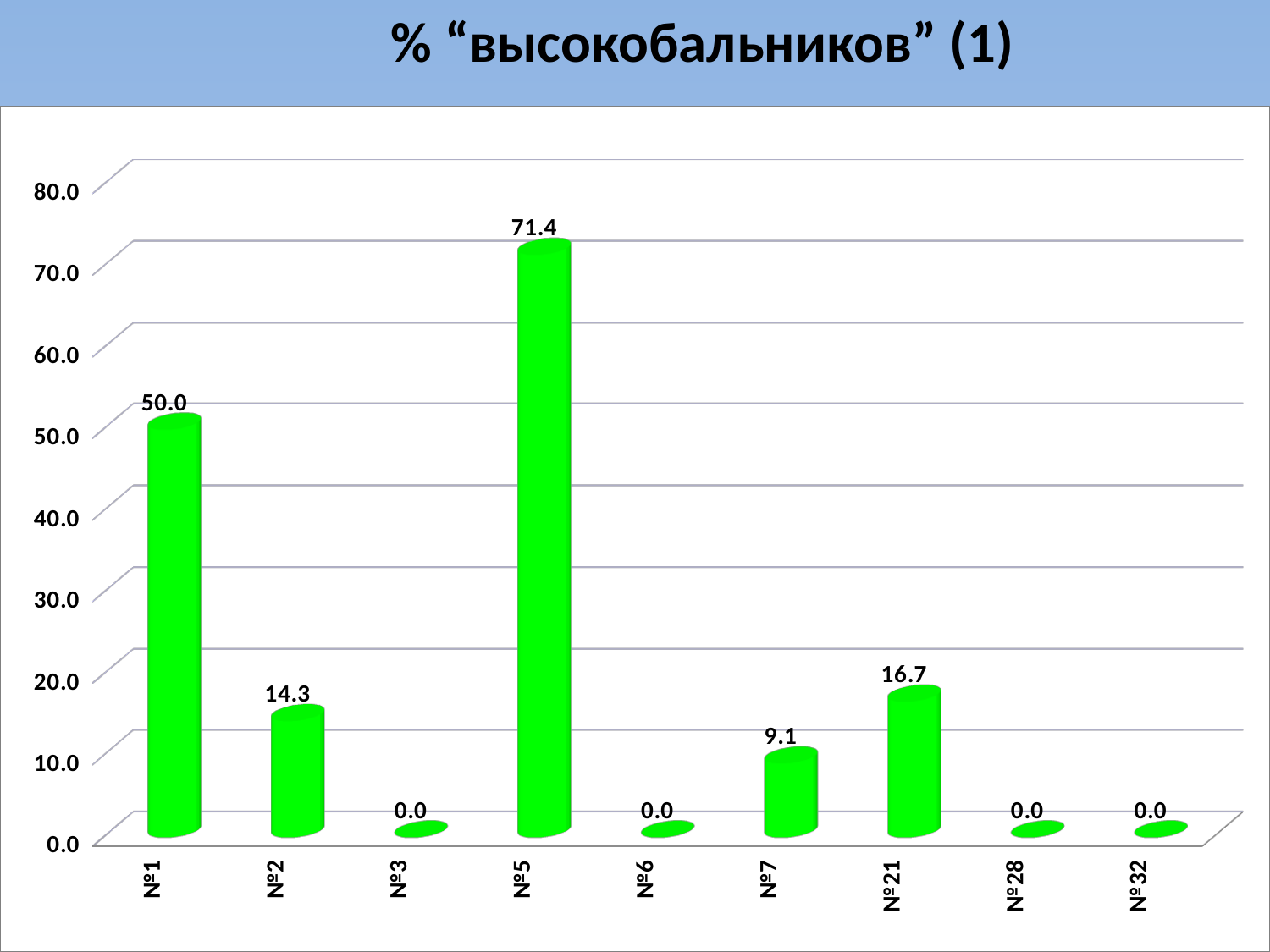
What is the value for №1? 50.0 Is the value for №1 greater or less than 40.0? greater What is the value for №5? 71.4 Which category has the highest value? №5 How many categories have a value of 0.0? 4 What kind of chart is shown on the slide? bar chart How many categories are shown on the x axis? 9 What is the value for №7? 9.1 What is the value for №21? 16.7 Which is larger, the value for №2 or the value for №7? №2 What is the difference between the values for №5 and №1? 21.4 What is the difference between the values for №21 and №2? 2.4